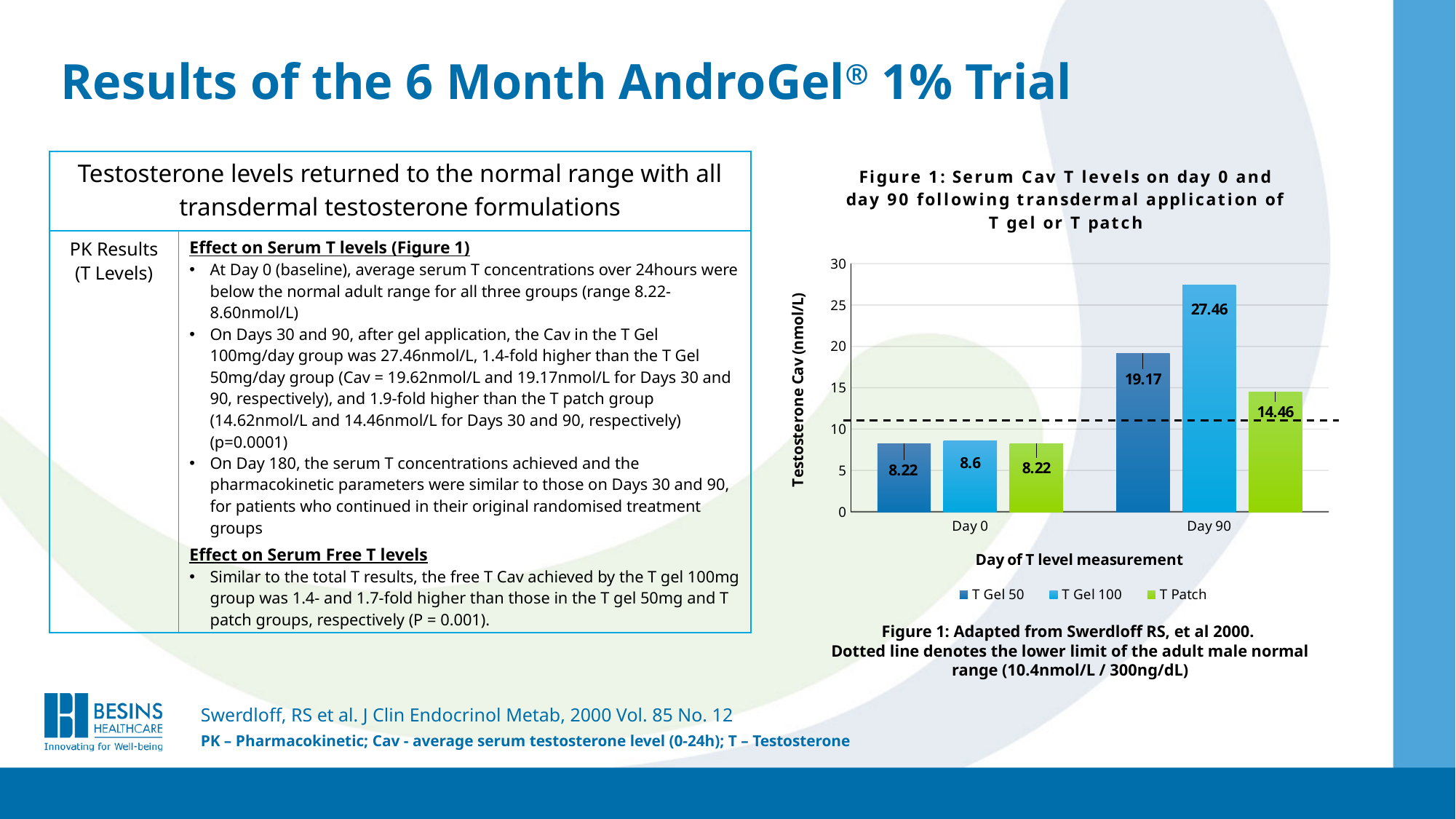
How many series does the legend list? 3 Is the T Patch value on Day 90 greater or less than 10? greater What is the difference between the T Gel 100 and T Gel 50 values on Day 90? 8.29 Which is larger on Day 0: the T Gel 100 value or the T Patch value? T Gel 100 What is the label of the y axis? Testosterone Cav (nmol/L) Which series has the lowest value on Day 90? T Patch What is the T Gel 100 value on Day 90? 27.46 How many categories are shown on the x axis? 2 What is the T Gel 50 value on Day 90? 19.17 Which series has the highest value on Day 90? T Gel 100 What kind of chart is shown? Bar chart What is the T Patch value on Day 0? 8.22